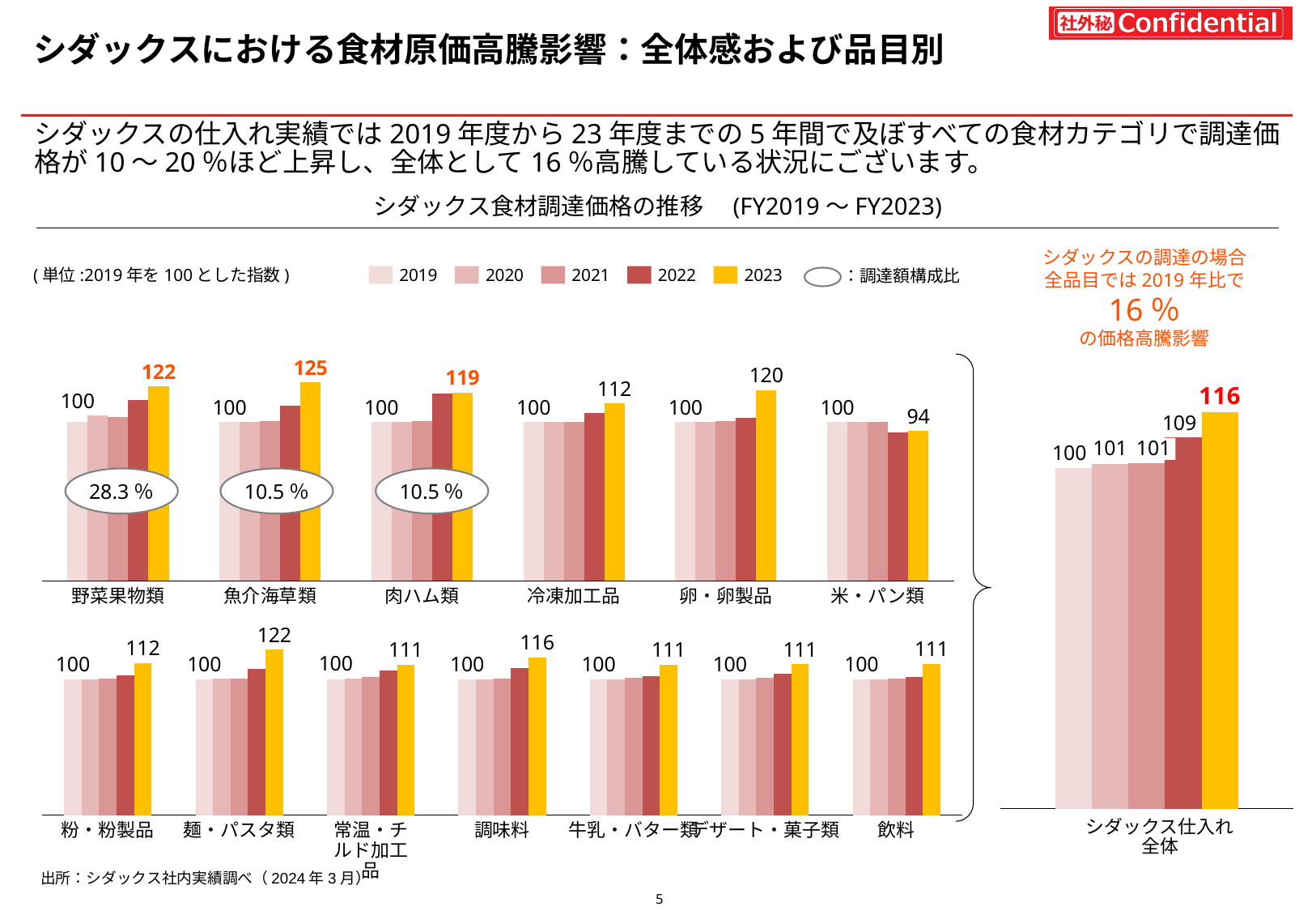
In the right-hand chart (シダックス仕入れ全体), what is the index value for 2022? 109 In the category chart, which food category has the lowest 2023 index value? 米・パン類 What kind of chart is used on this slide? bar chart In the category chart (シダックス食材調達価格の推移), what is the 2023 index value for 魚介海草類? 125 In the right-hand chart (シダックス仕入れ全体), do the index values rise or fall from 2019 to 2023? rise In the category chart, which food category has the highest 2023 index value? 魚介海草類 In the category chart, what is the 2023 index value for 米・パン類? 94 In the category chart, what is the difference between the 2023 index values of 野菜果物類 and 冷凍加工品? 10 In the category chart, what procurement share (調達額構成比) is shown for 野菜果物類? 28.3 % How many food categories are shown in the category chart? 13 In the category chart, which has a higher 2023 index value, 卵・卵製品 or 調味料? 卵・卵製品 How many years (series) does the legend list? 5